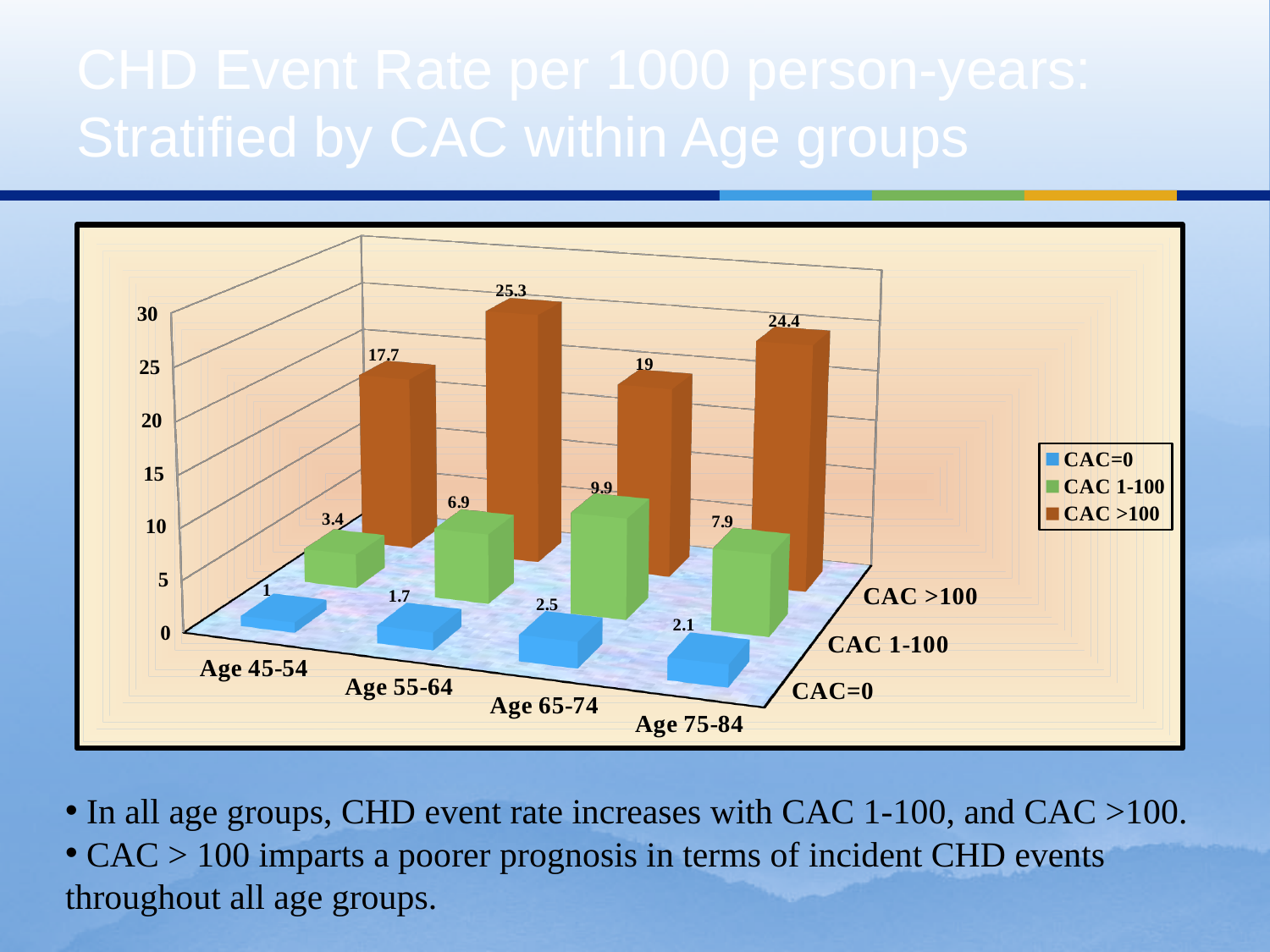
Which is larger: the CAC >100 event rate for Age 65-74 or for Age 75-84? Age 75-84 How many age groups are shown on the chart? 4 What kind of chart is shown on the slide? Bar chart How many series does the legend list? 3 Which age group has the lowest CHD event rate for CAC 1-100? Age 45-54 Is the CAC >100 event rate for Age 45-54 greater or less than 15? greater What is the difference between the CAC >100 and CAC=0 event rates in the Age 75-84 group? 22.3 What is the CHD event rate for CAC=0 in the Age 45-54 group? 1 Which colour represents the CAC 1-100 series in the chart? Green What is the CHD event rate for CAC >100 in the Age 55-64 group? 25.3 Which age group has the highest CHD event rate for CAC >100? Age 55-64 What is the CHD event rate for CAC 1-100 in the Age 65-74 group? 9.9